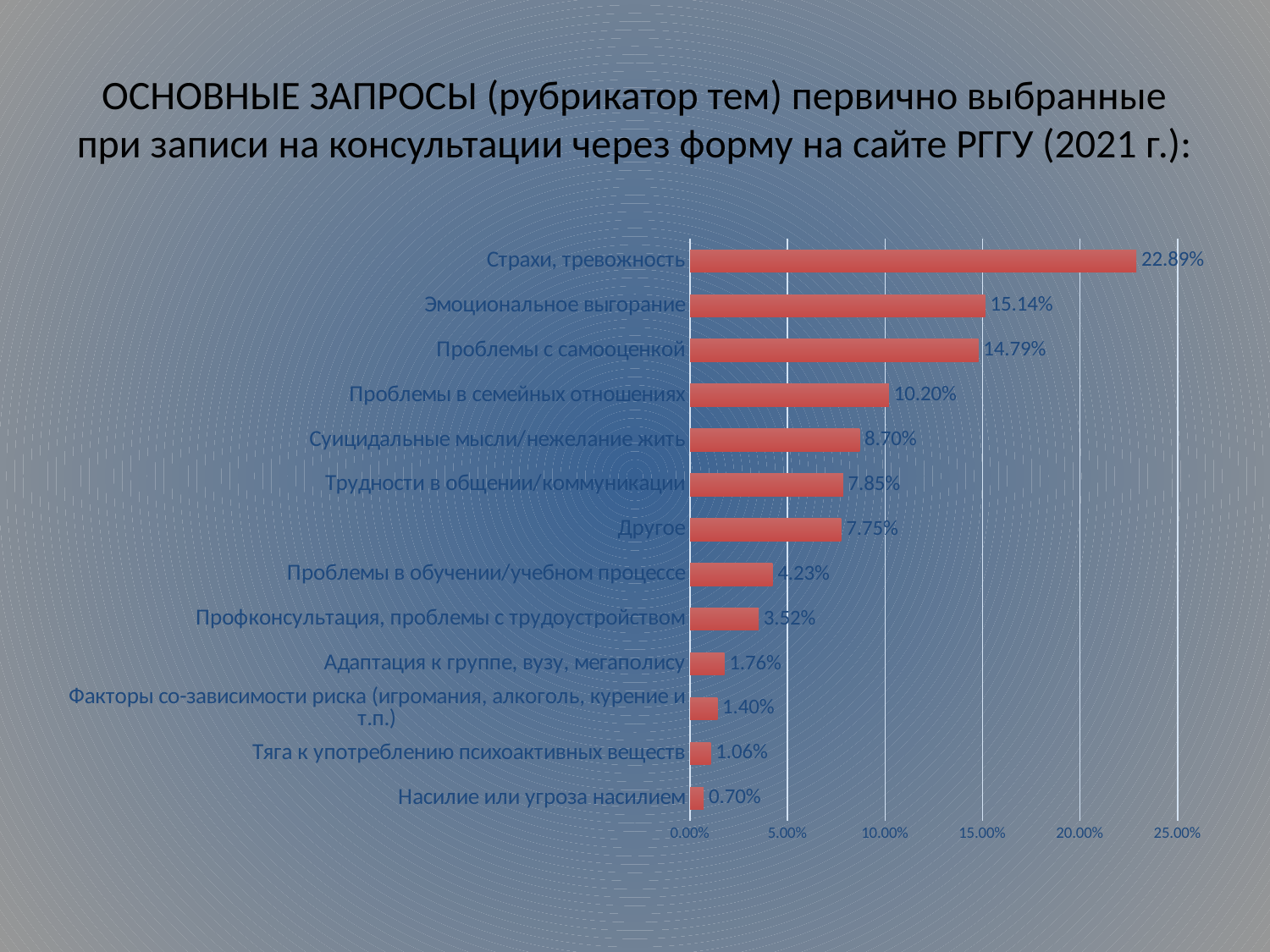
Which category has the highest value? Страхи, тревожность Which is larger: the value for Суицидальные мысли/нежелание жить or the value for Трудности в общении/коммуникации? Суицидальные мысли/нежелание жить What is the difference between the values for Эмоциональное выгорание and Проблемы с самооценкой? 0.35% What is the value for Страхи, тревожность? 22.89% How many categories are shown in the chart? 13 What is the value for Проблемы в семейных отношениях? 10.20% What kind of chart is shown on the slide? bar chart Which category has the lowest value? Насилие или угроза насилием What is the difference between the values for Страхи, тревожность and Насилие или угроза насилием? 22.19% What is the value for Профконсультация, проблемы с трудоустройством? 3.52% What is the maximum value shown on the horizontal axis? 25.00% Is the value for Проблемы в обучении/учебном процессе greater or less than 5.00%? less